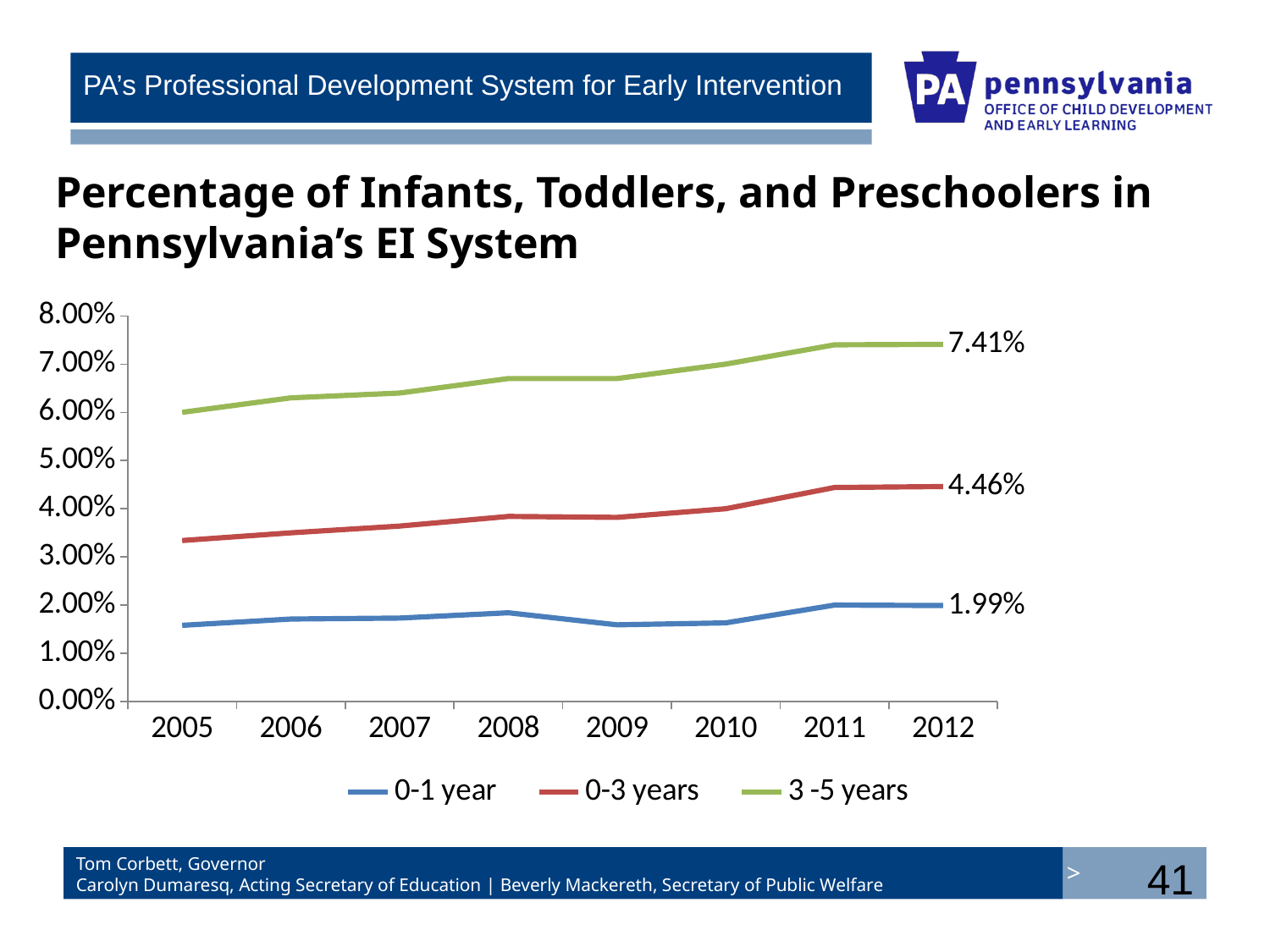
What kind of chart is shown on the slide? line chart What is the value for the 3 -5 years series in 2012? 7.41% What is the value for the 0-1 year series in 2012? 1.99% What is the value for the 0-3 years series in 2012? 4.46% What is the difference between the 3 -5 years value and the 0-3 years value in 2012? 2.95% How many series does the legend list? 3 Is the value for the 3 -5 years series in 2005 greater or less than 5.00%? greater Does the 3 -5 years series generally rise or fall from 2005 to 2012? rise Is the value for the 0-1 year series in 2005 greater or less than 2.00%? less What is the difference between the 0-3 years value and the 0-1 year value in 2012? 2.47% Which series has the higher value in 2012, 3 -5 years or 0-1 year? 3 -5 years How many years are shown on the x axis? 8